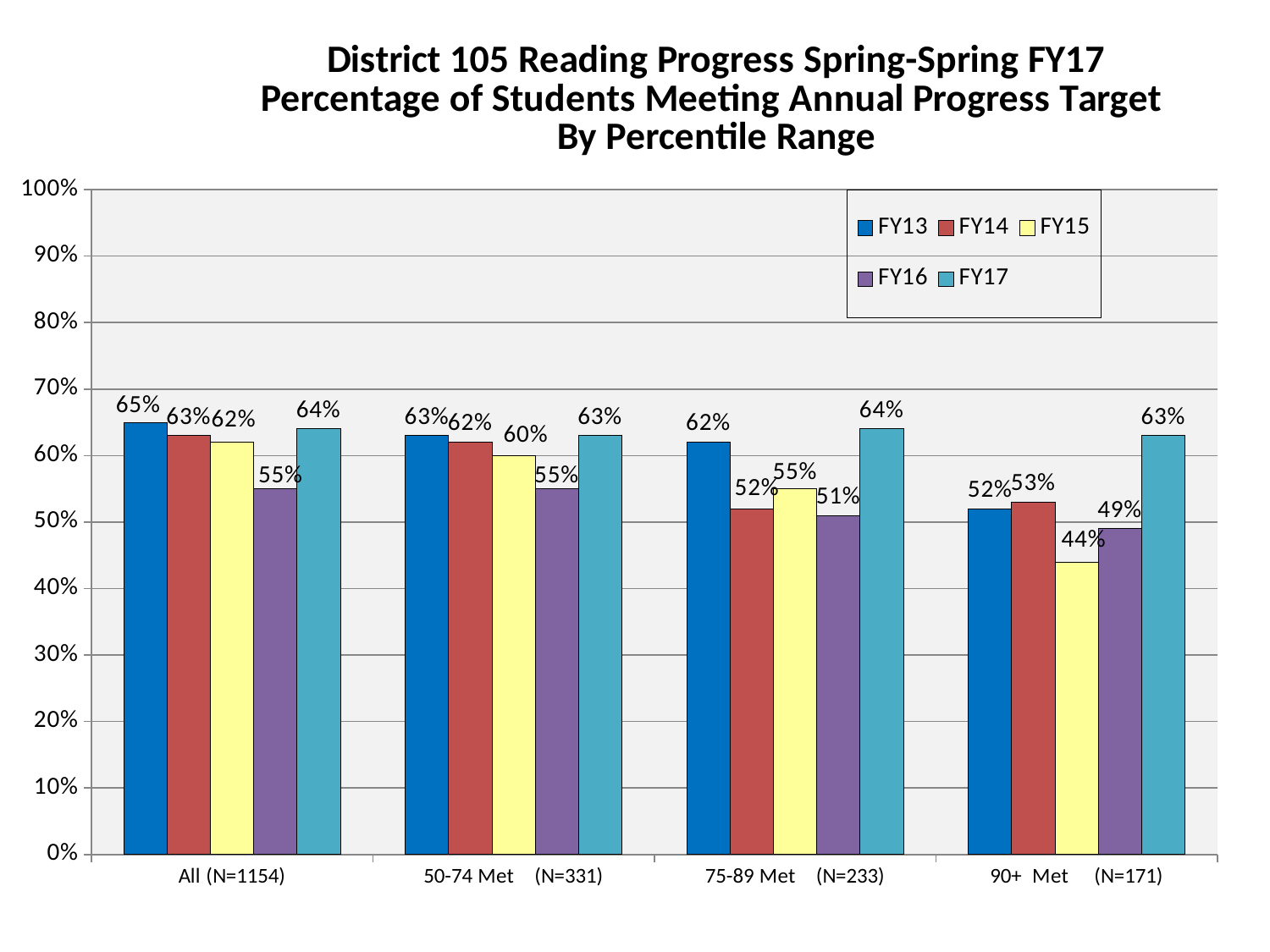
Which series has the highest value in the 75-89 Met (N=233) category? FY17 Do the FY13 values rise or fall from the All (N=1154) category to the 90+ Met (N=171) category? Fall How many series does the legend list? 5 What is the FY16 value for the 75-89 Met (N=233) category? 51% Which is larger in the 50-74 Met (N=331) category, the FY15 value or the FY16 value? FY15 What is the FY15 value for the 90+ Met (N=171) category? 44% How many categories are shown on the x axis? 4 Which category has the lowest FY15 value? 90+ Met (N=171) What colour are the FY17 bars? Teal What is the difference between the FY17 and FY16 values for the 90+ Met (N=171) category? 14% What kind of chart is shown on the slide? Bar chart What is the FY17 value for the All (N=1154) category? 64%